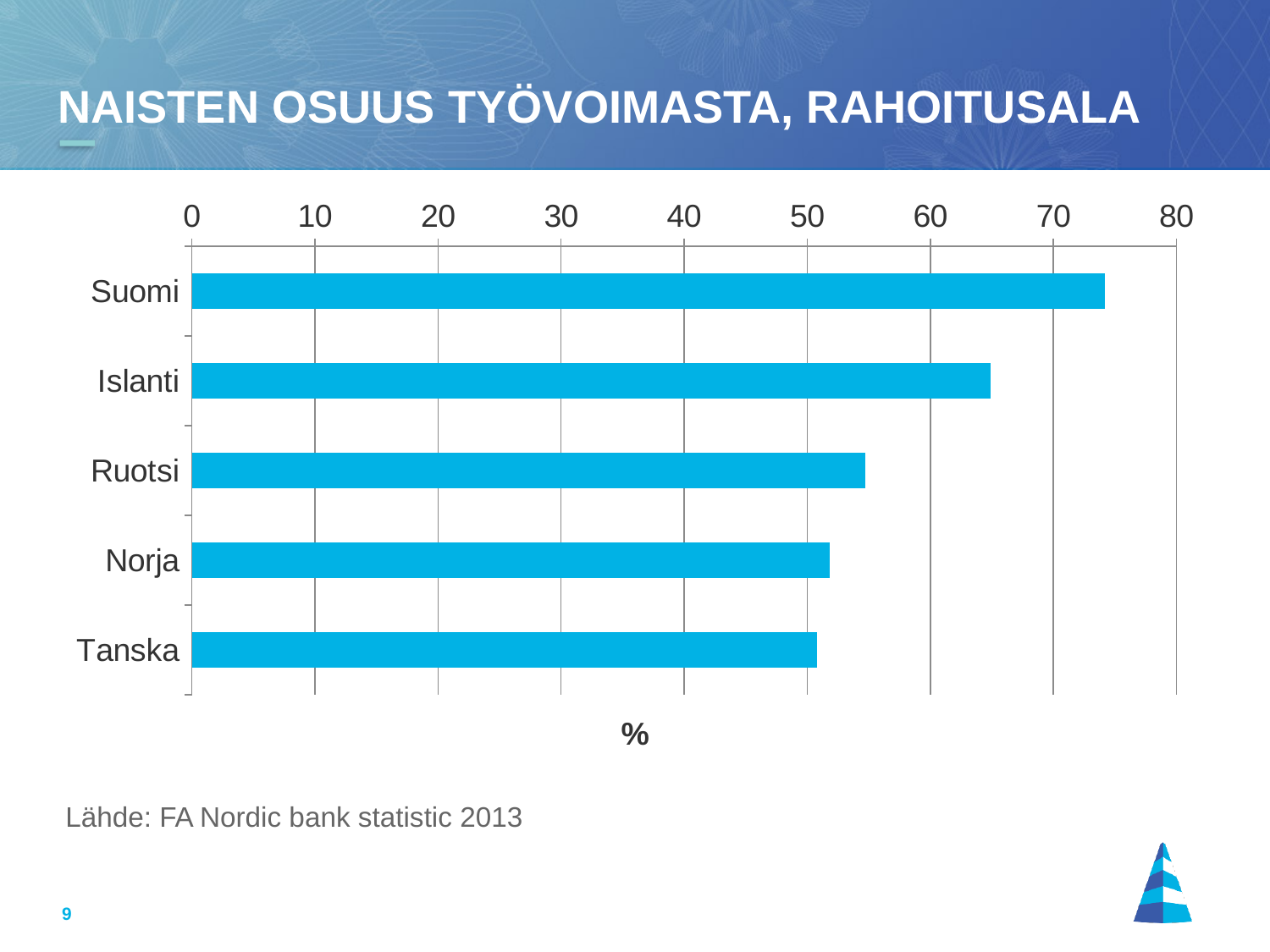
How many countries are shown in the chart? 5 Is the value for Islanti greater or less than 60? greater Is the value for Tanska greater or less than 60? less What kind of chart is shown on the slide? bar chart What is the title of the chart? NAISTEN OSUUS TYÖVOIMASTA, RAHOITUSALA Is the value for Islanti greater or less than 70? less Which country has the highest share of women in the financial sector workforce? Suomi Which has a larger value, Suomi or Islanti? Suomi What unit is shown on the horizontal axis of the chart? %